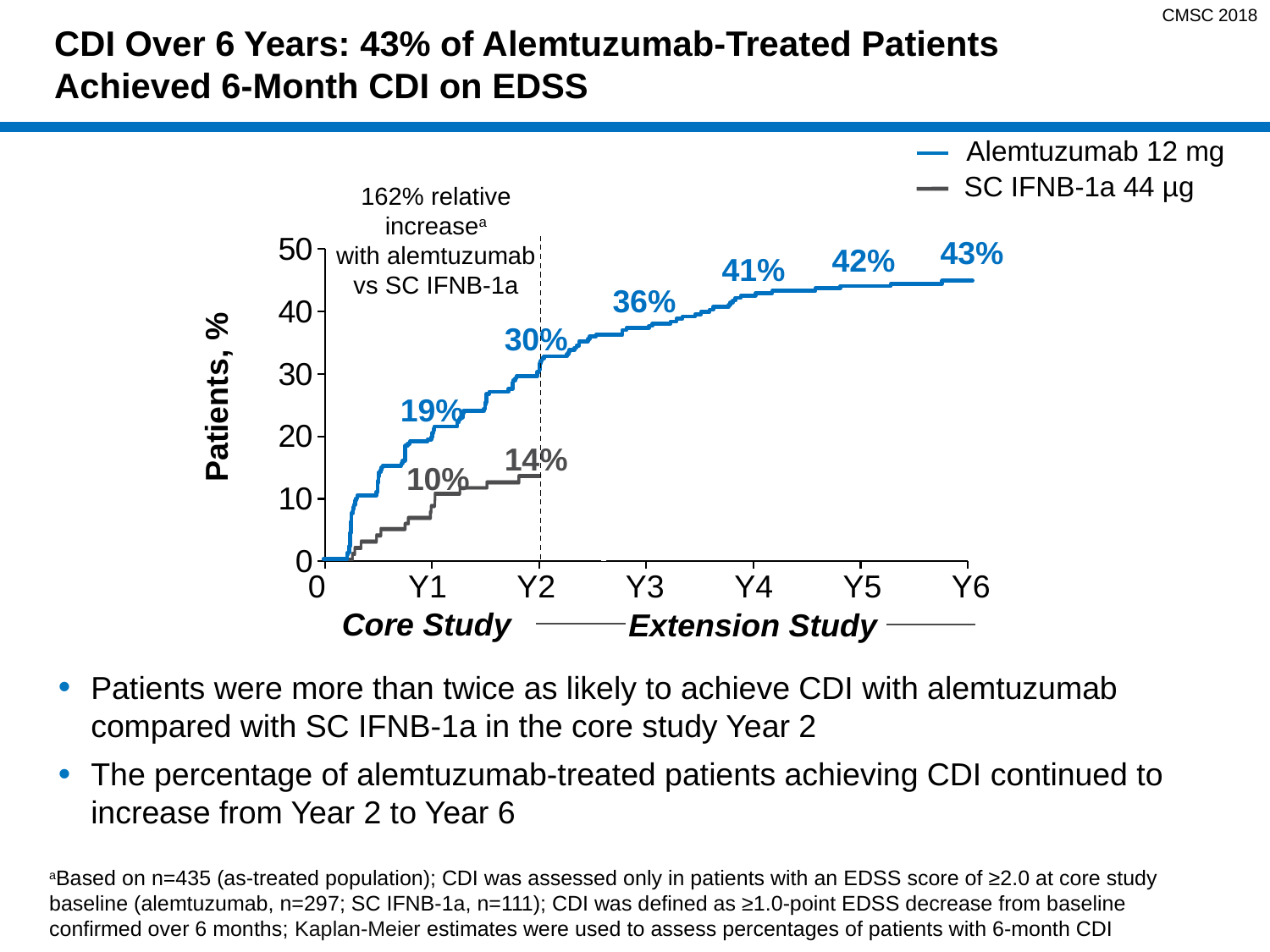
What kind of chart is shown on the slide? Line chart What is the difference between the alemtuzumab 12 mg and SC IFNB-1a 44 µg values at Year 2? 16% What percentage of SC IFNB-1a 44 µg patients achieved 6-month CDI at Year 2? 14% What is the label on the y axis of the chart? Patients, % What is the difference between the alemtuzumab 12 mg values at Year 6 and Year 2? 13% How many series does the legend list? 2 Is the alemtuzumab 12 mg value at Year 3 greater or less than 30? greater At Year 1, which series has the higher value: alemtuzumab 12 mg or SC IFNB-1a 44 µg? Alemtuzumab 12 mg Does the alemtuzumab 12 mg line rise or fall from Year 2 to Year 6? Rise What is the labelled value for alemtuzumab 12 mg at Year 4? 41% What is the labelled value for alemtuzumab 12 mg at Year 1? 19% What percentage of alemtuzumab 12 mg patients achieved 6-month CDI at Year 6? 43%